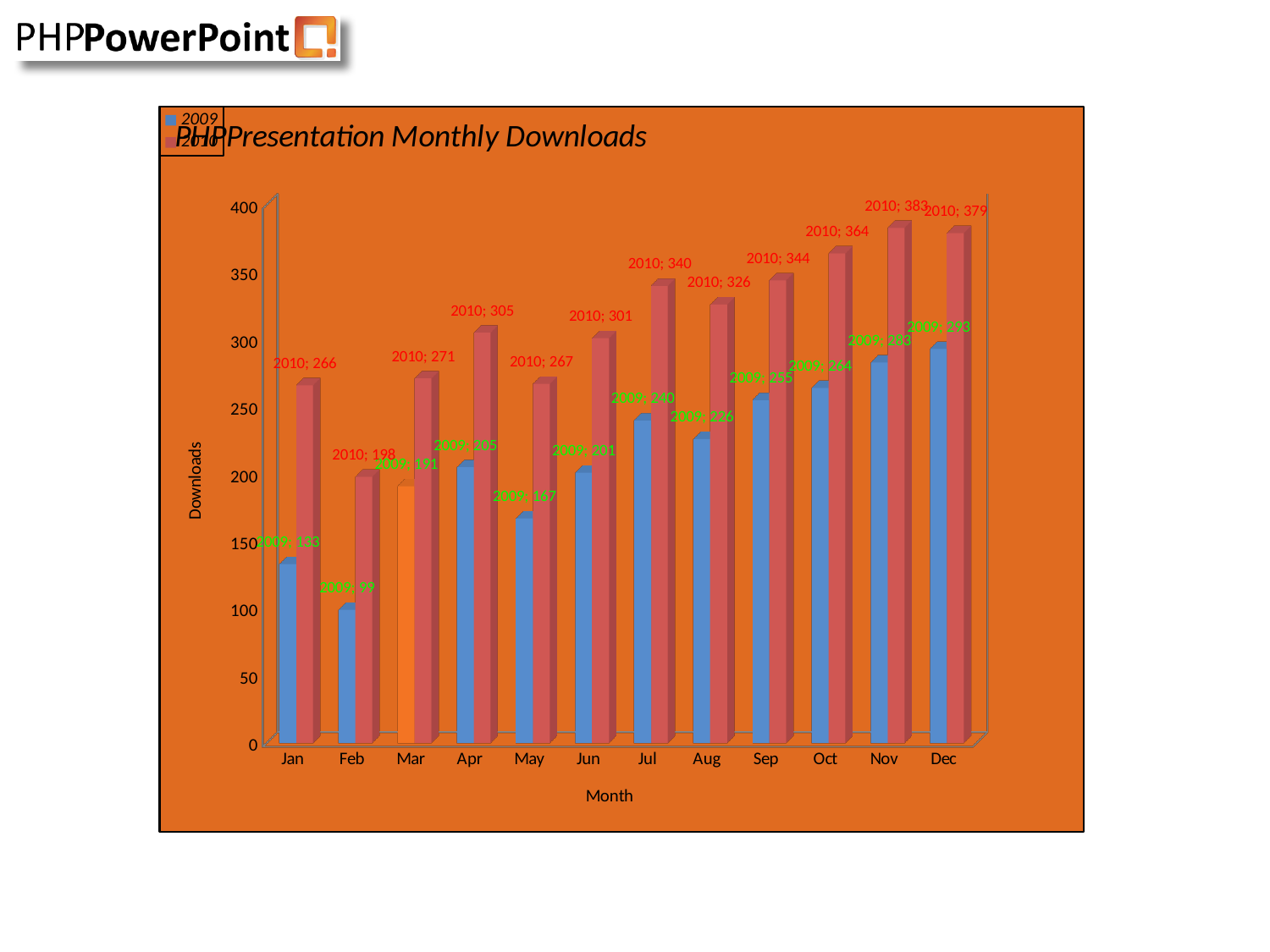
Is the 2010 value for Apr greater or less than 300? greater What kind of chart is shown? bar chart Which is larger, the 2009 value for Mar or the 2010 value for Feb? 2010 value for Feb What is the difference between the 2010 and 2009 values for Dec? 86 What is the 2009 value for Jul? 240 How many months are shown on the x axis? 12 What is the 2010 value for Nov? 383 What is the 2009 value for Feb? 99 How many series does the legend list? 2 What is the title of the chart? PHPPresentation Monthly Downloads Which month has the lowest 2009 value? Feb Which month has the highest 2010 value? Nov